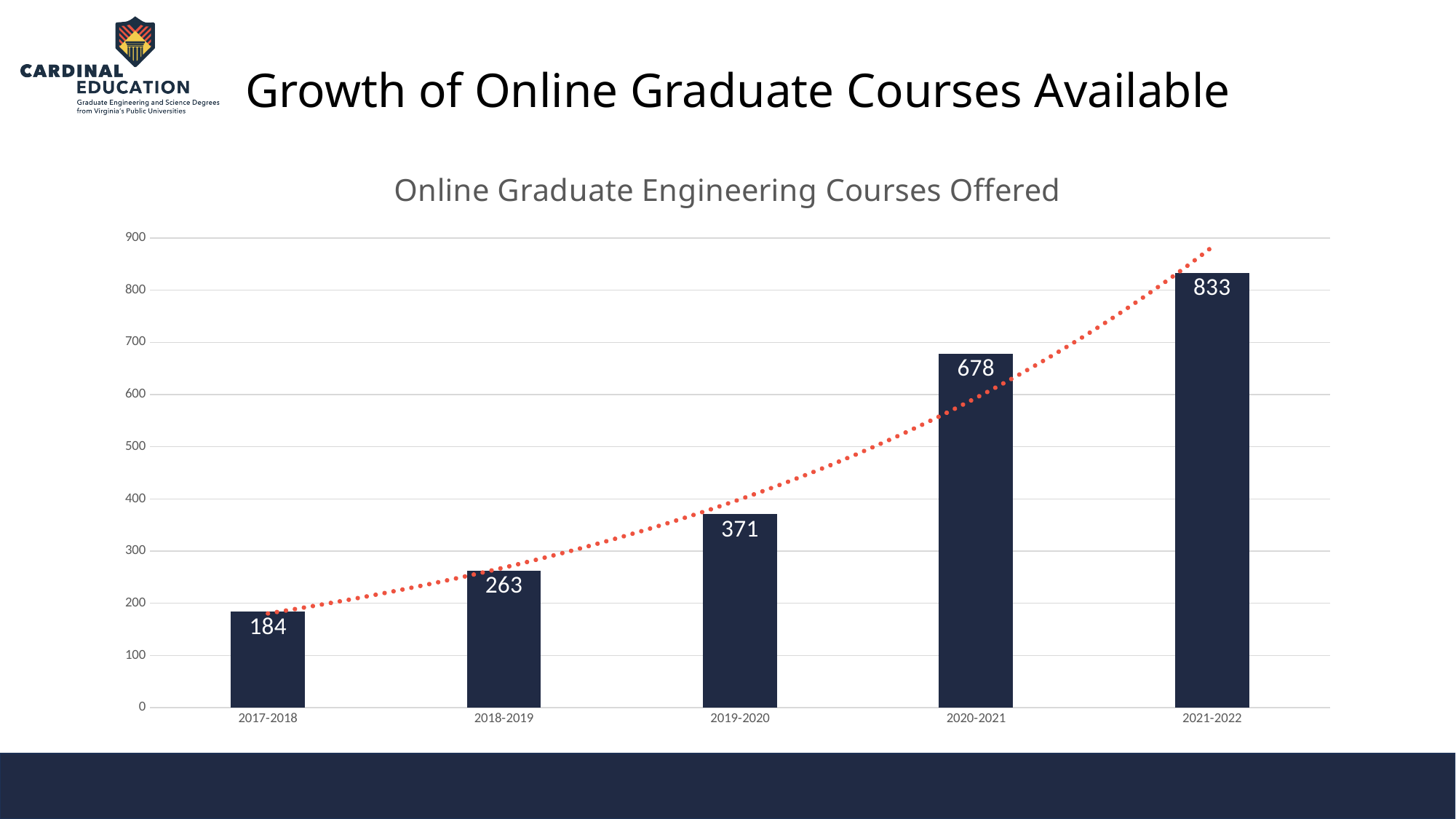
What is the difference between the values for 2019-2020 and 2018-2019? 108 How many academic years are shown on the x axis? 5 Is the value for 2020-2021 greater or less than 600? greater Do the values rise or fall from 2017-2018 to 2021-2022? rise Which is larger, the value for 2020-2021 or the value for 2019-2020? 2020-2021 Which academic year has the highest number of online graduate engineering courses offered? 2021-2022 What kind of chart is shown on the slide? bar chart Which academic year has the lowest number of online graduate engineering courses offered? 2017-2018 What is the value for 2017-2018? 184 What is the difference between the values for 2021-2022 and 2020-2021? 155 What is the value for 2021-2022? 833 What is the value for 2019-2020? 371